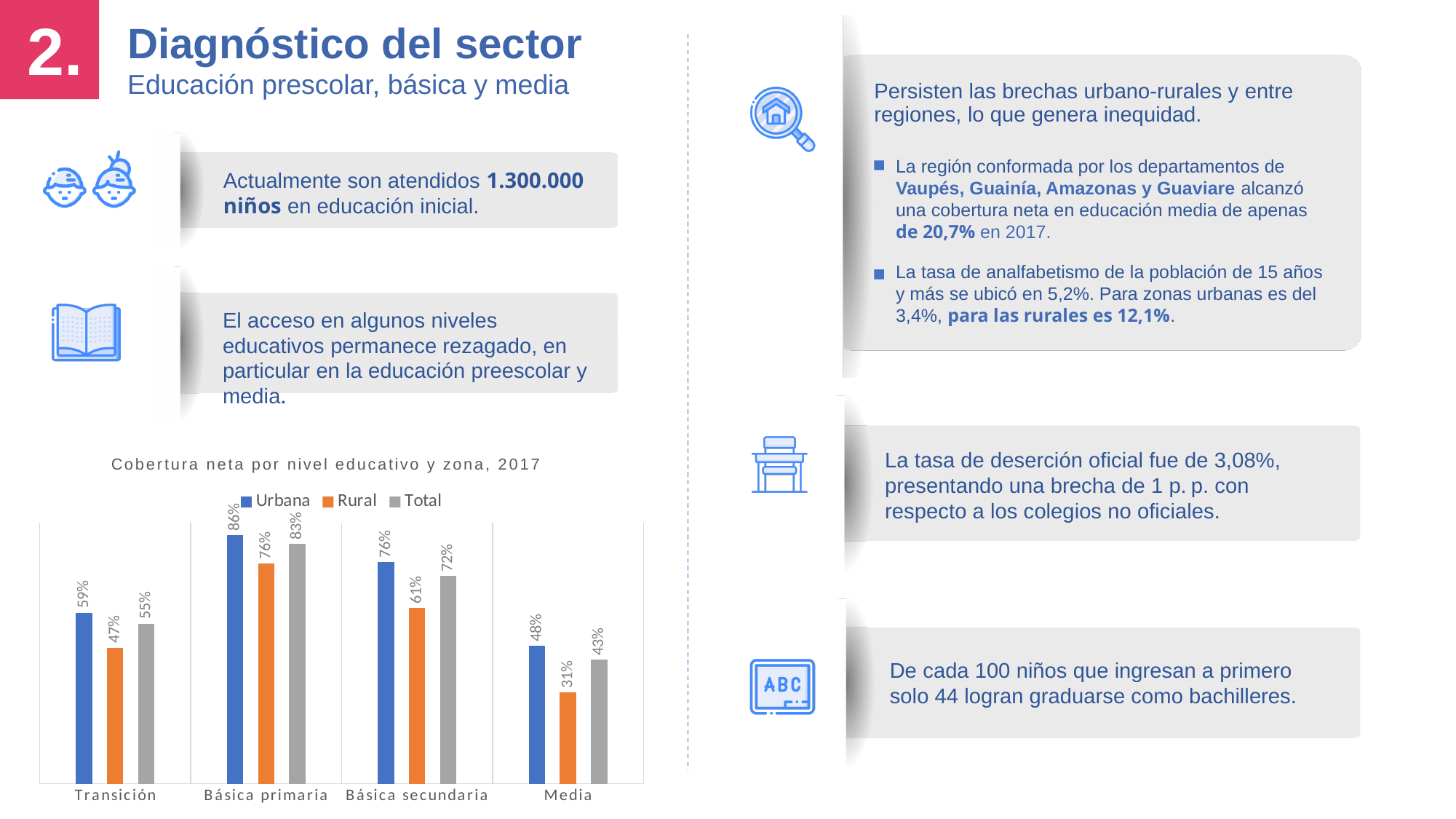
Which category has the lowest Rural value? Media What is the Total value for Básica secundaria? 72% What is the difference between the Urbana and Rural values for Básica secundaria? 15% How many series does the chart legend list? 3 How many categories are shown on the x axis of the chart? 4 What is the Rural value for Media? 31% What is the title of the chart? Cobertura neta por nivel educativo y zona, 2017 Which category has the highest Urbana value? Básica primaria What is the Rural value for Transición? 47% Which is larger for Transición: the Urbana value or the Total value? Urbana What kind of chart is shown on the slide? Bar chart What is the Urbana value for Básica primaria? 86%